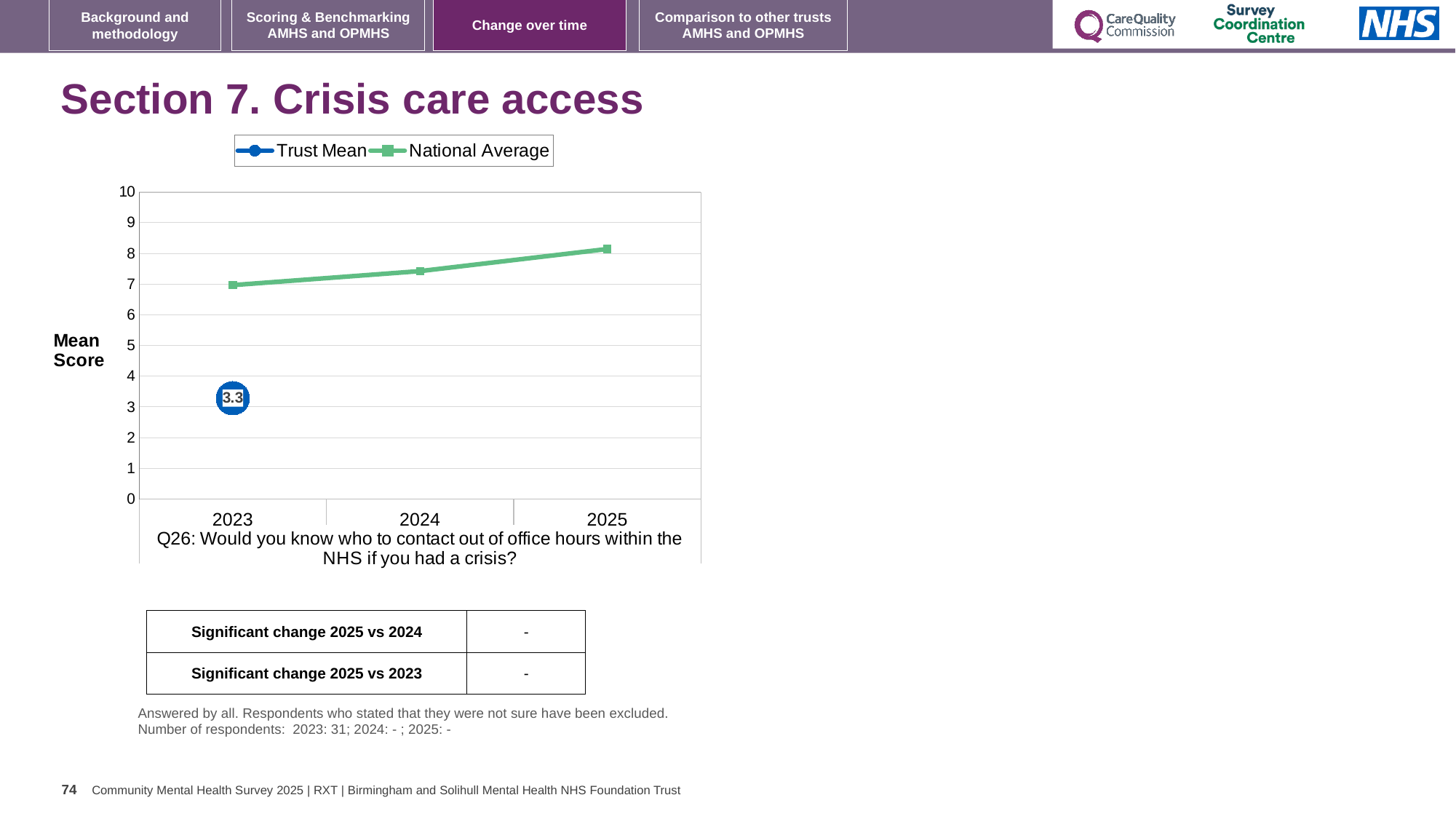
In which year is the National Average highest? 2025 What is the label on the y axis of the chart? Mean Score What is the Trust Mean value for 2023? 3.3 Does the National Average rise or fall from 2023 to 2025? Rise Is the National Average value for 2025 greater or less than 7? greater Is the National Average value for 2023 greater or less than 8? less In which year is the National Average lowest? 2023 In 2023, which is larger: the Trust Mean or the National Average? National Average How many years are shown on the x axis? 3 Is the National Average value for 2024 greater or less than 6? greater What kind of chart is shown on the slide? Line chart How many series does the legend list? 2